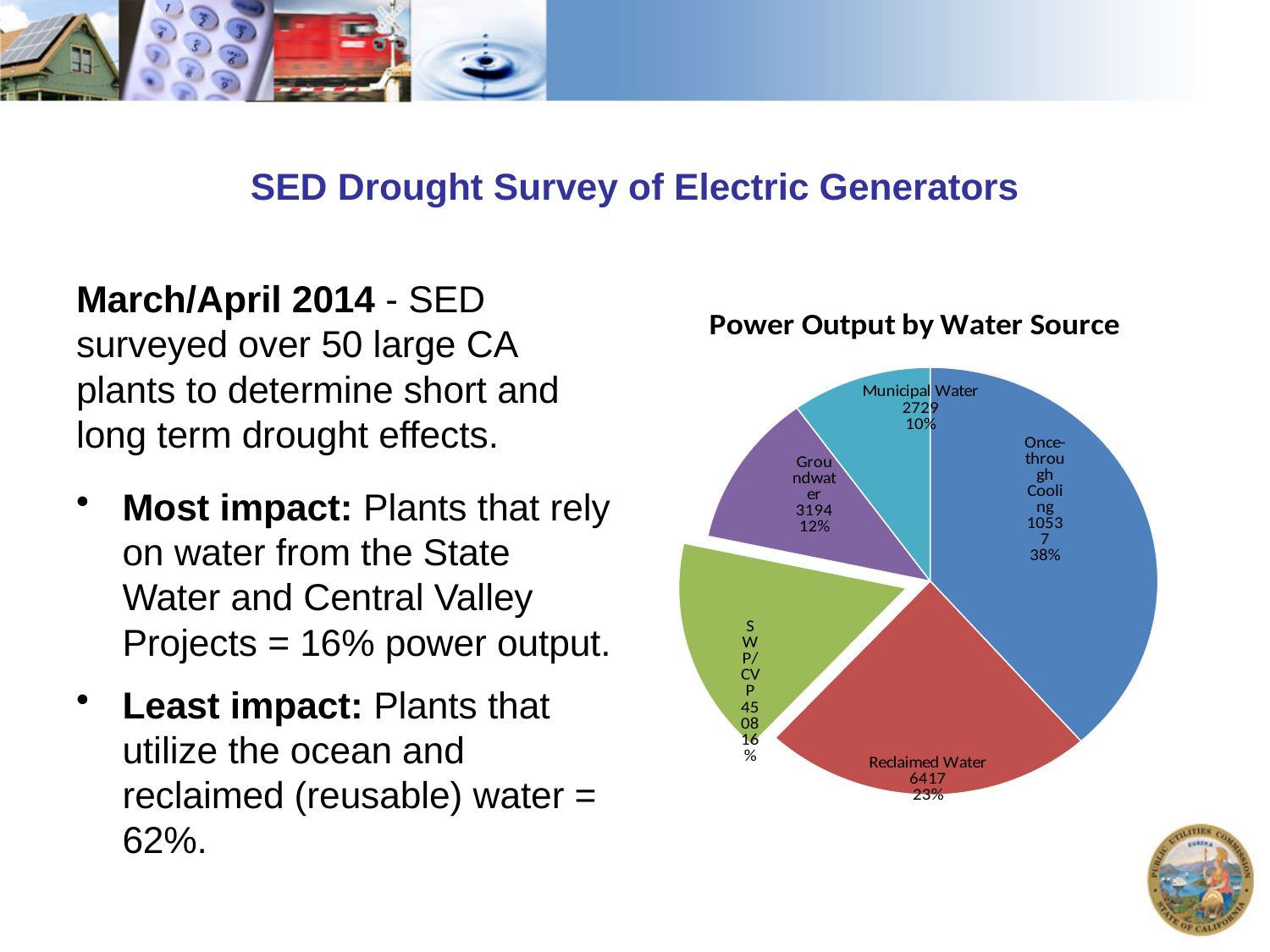
What is the power output value for Groundwater? 3194 What is the difference between the values for Reclaimed Water and SWP/CVP? 1909 What is the power output value for Reclaimed Water? 6417 How many slices does the pie chart have? 5 What is the power output value for Once-through Cooling? 10537 Which water source has the smallest slice of the pie? Municipal Water What share of the pie does Once-through Cooling represent? 38% What kind of chart is shown on the slide? Pie chart Which water source has the largest slice of the pie? Once-through Cooling What share of the pie does SWP/CVP represent? 16% What is the power output value for Municipal Water? 2729 What is the title of the chart? Power Output by Water Source